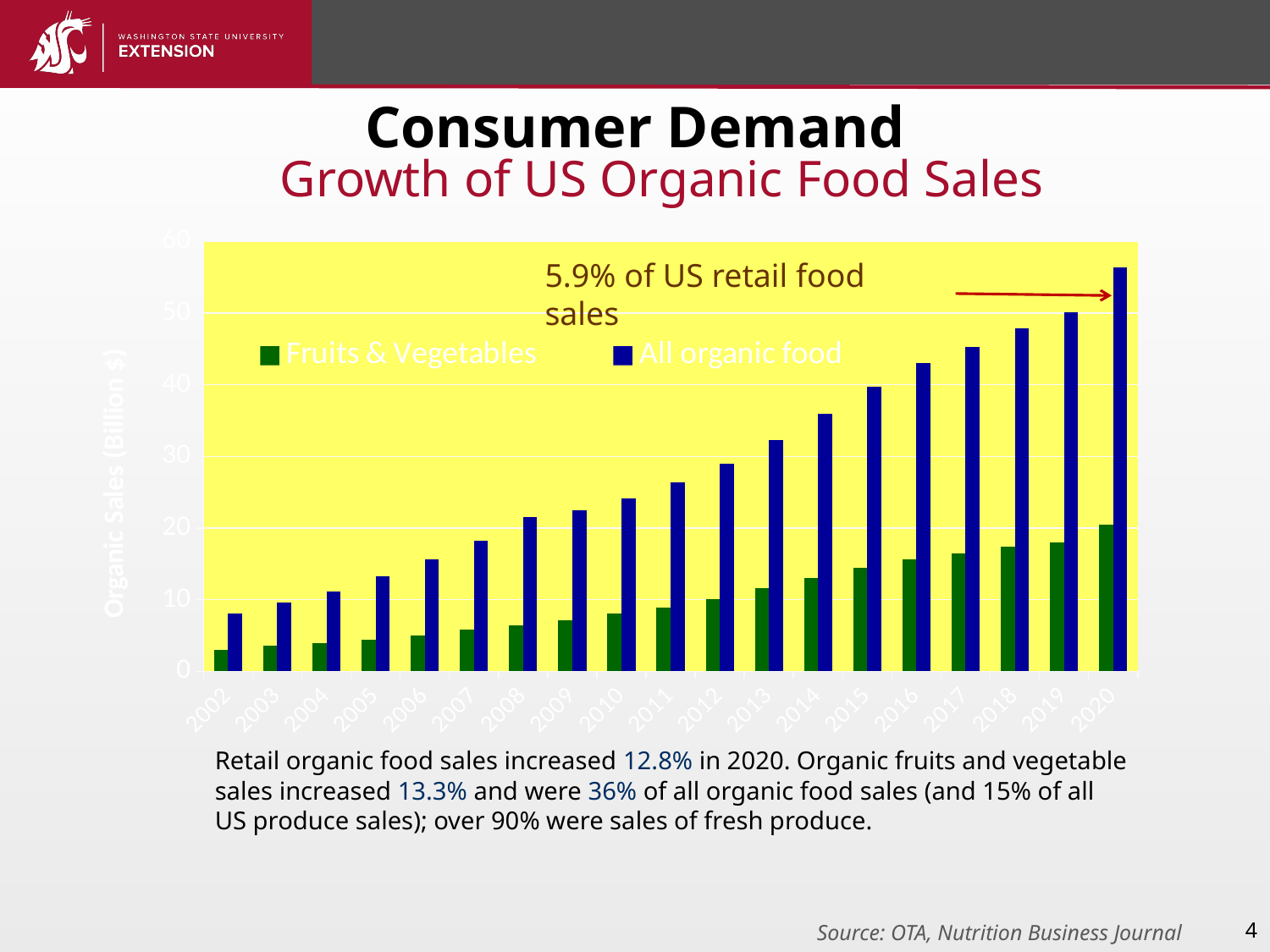
How many years are shown on the x axis of the chart? 19 Is the value for All organic food in 2002 greater or less than 10? less What kind of chart is shown on the slide? bar chart Is the value for All organic food in 2020 greater or less than 50? greater Which is larger in 2020: All organic food or Fruits & Vegetables? All organic food Do the All organic food values rise or fall from 2002 to 2020? rise Is the value for Fruits & Vegetables in 2016 greater or less than 10? greater Which year has the lowest value for Fruits & Vegetables? 2002 What is the label of the y axis of the chart? Organic Sales (Billion $) How many series does the chart legend list? 2 Which year has the highest value for All organic food? 2020